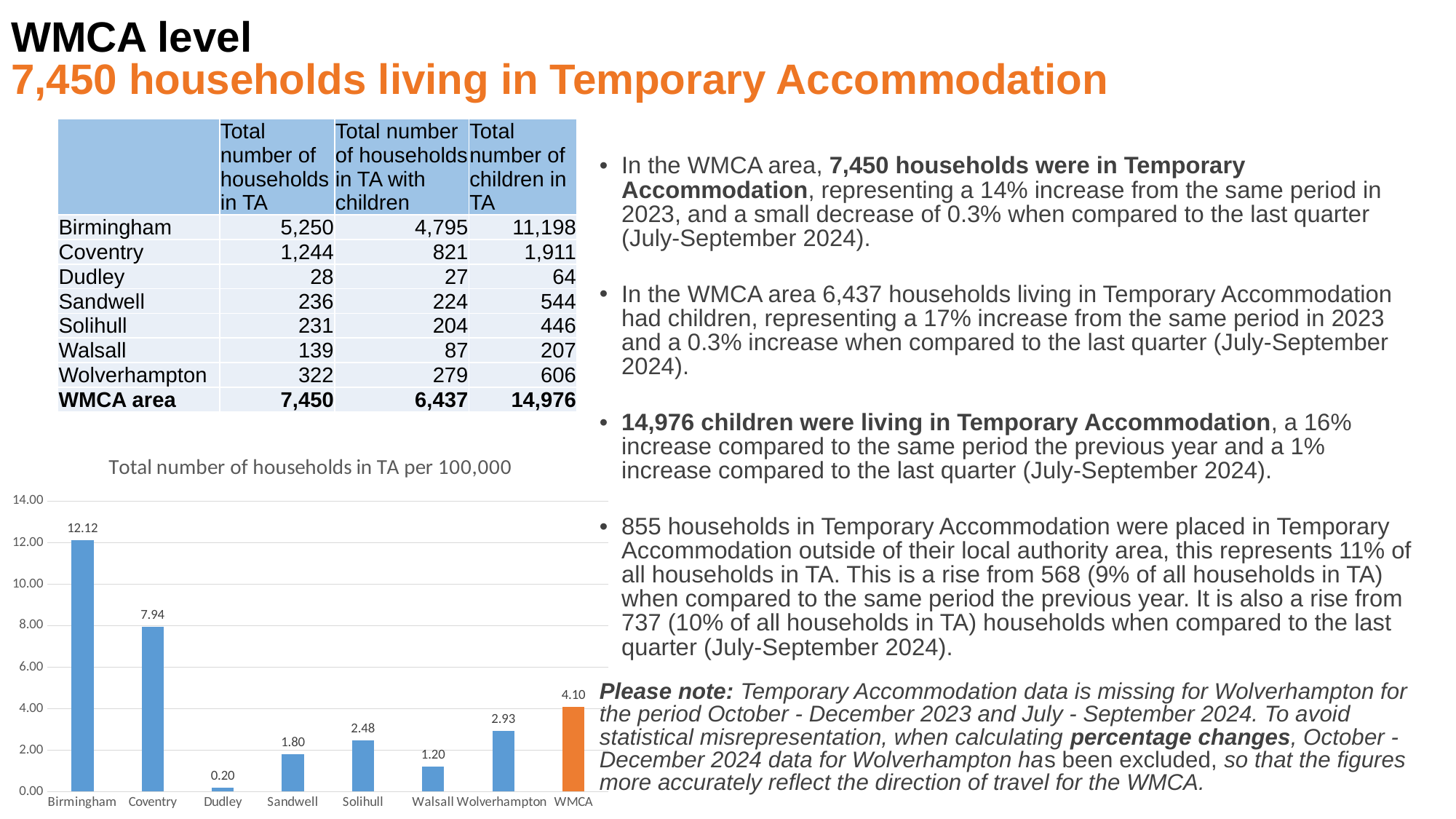
Which has a larger value, Solihull or Sandwell? Solihull What is the value for Coventry in the chart? 7.94 Which category has the lowest value in the chart? Dudley What is the value for WMCA in the chart? 4.10 What is the difference between the values for Birmingham and Coventry? 4.18 What is the title of the chart? Total number of households in TA per 100,000 What is the value for Birmingham in the chart? 12.12 What is the value for Wolverhampton in the chart? 2.93 Is the value for Walsall greater or less than 2.00? less Which category has the highest value in the chart? Birmingham What kind of chart is shown on the slide? bar chart How many categories are shown on the x axis of the chart? 8